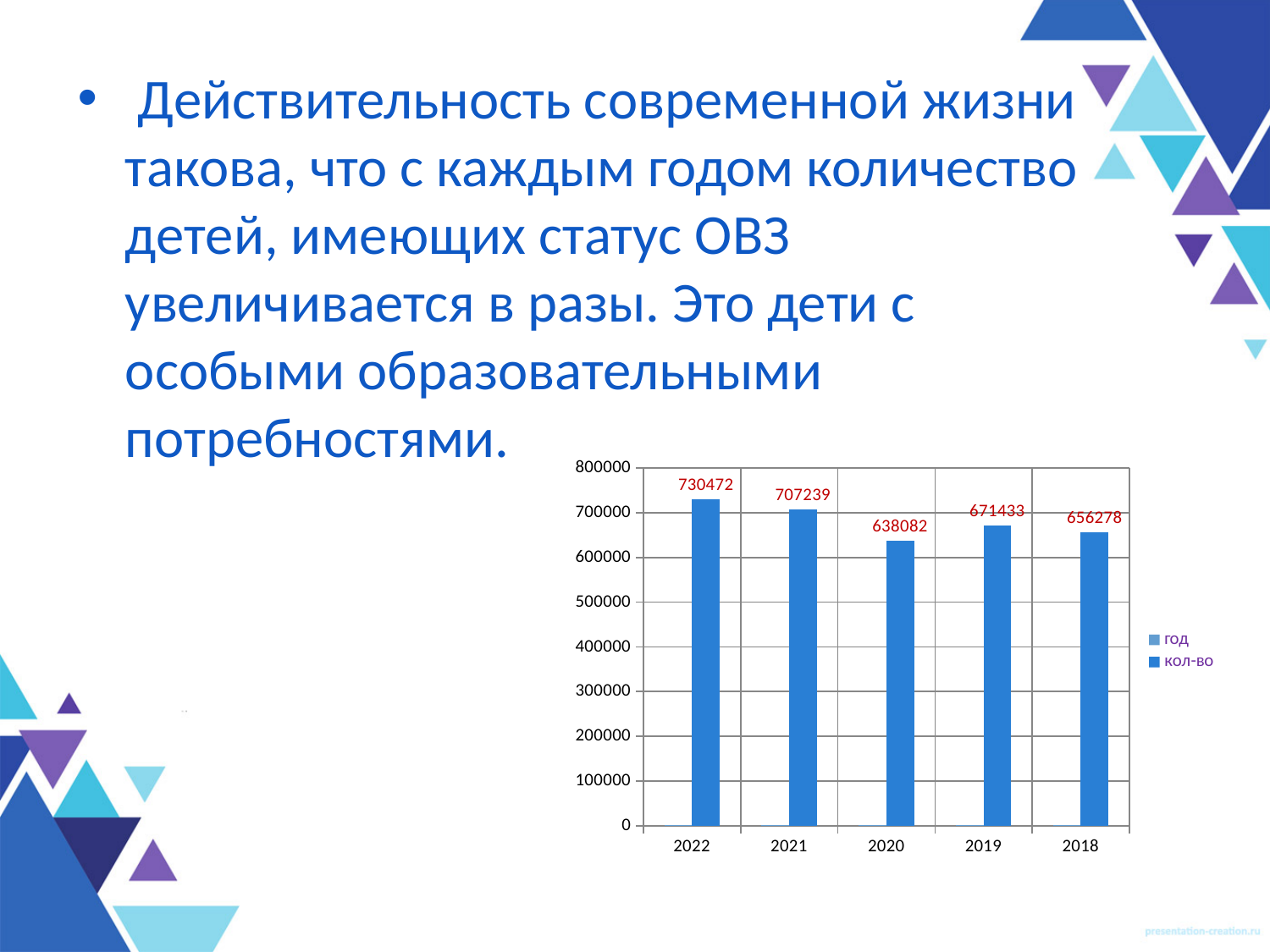
What is the value for 2022? 730472 Which year has the lowest value? 2020 Is the value for 2021 greater or less than 600000? greater Which year has the highest value? 2022 What is the value for 2020? 638082 Which is larger, the value for 2019 or the value for 2020? 2019 What is the difference between the values for 2022 and 2021? 23233 How many years are shown on the x axis? 5 What is the value for 2018? 656278 What is the difference between the values for 2019 and 2018? 15155 What kind of chart is shown on the slide? bar chart How many entries does the legend list? 2